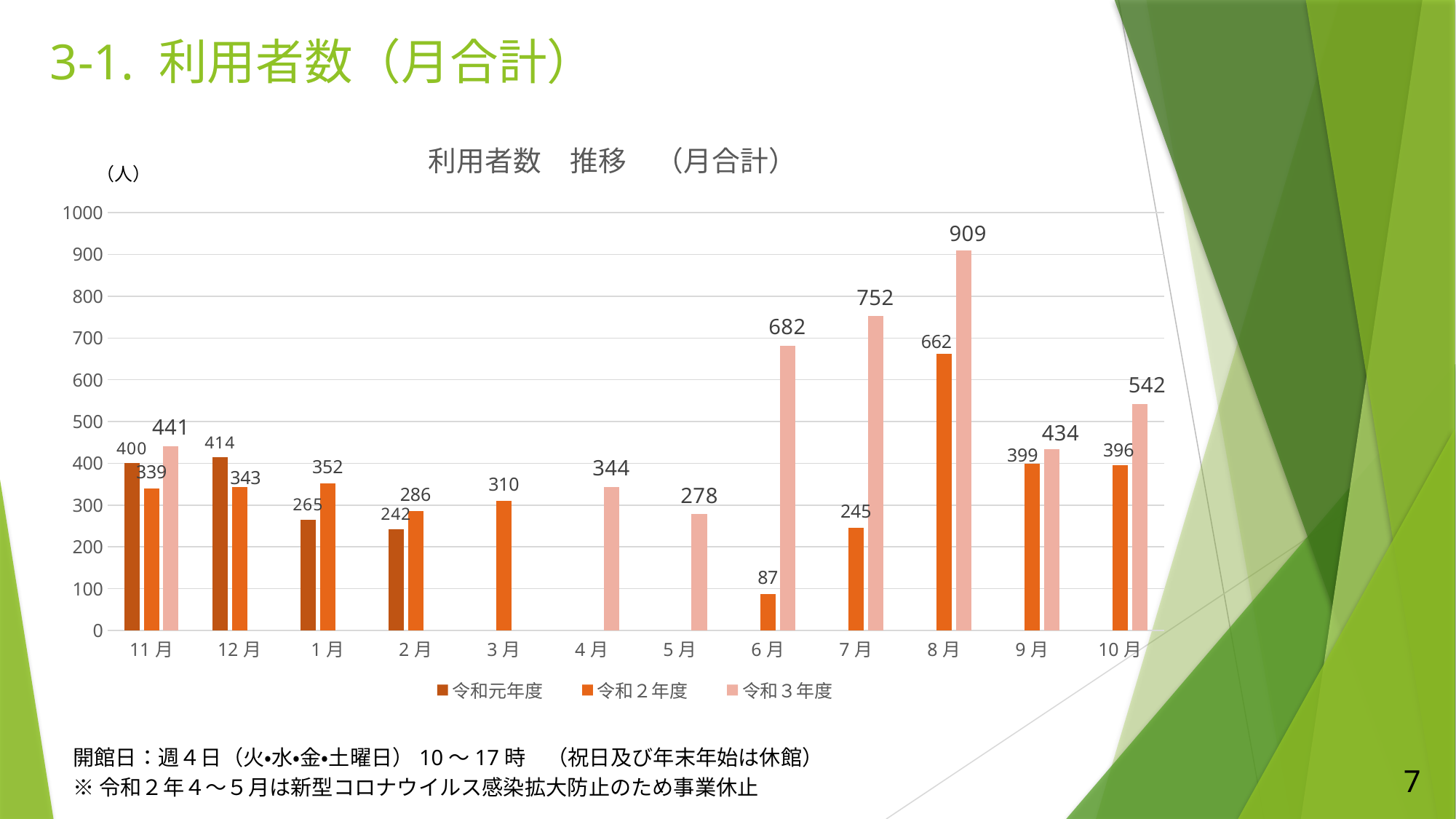
What is the unit label shown at the top of the vertical axis? （人） How many series does the legend list? 3 What is the difference between the 令和３年度 and 令和２年度 values in ７月? 507 What is the value for 令和３年度 in ８月? 909 How many months are shown on the x axis? 12 What is the value for 令和２年度 in ６月? 87 Is the value for 令和３年度 in ６月 greater or less than 600? greater What is the value for 令和元年度 in １２月? 414 What kind of chart is shown on the slide? bar chart Which month has the highest value for the 令和３年度 series? ８月 Which month has the lowest value for the 令和２年度 series? ６月 Which is larger in １月: the 令和元年度 value or the 令和２年度 value? 令和２年度